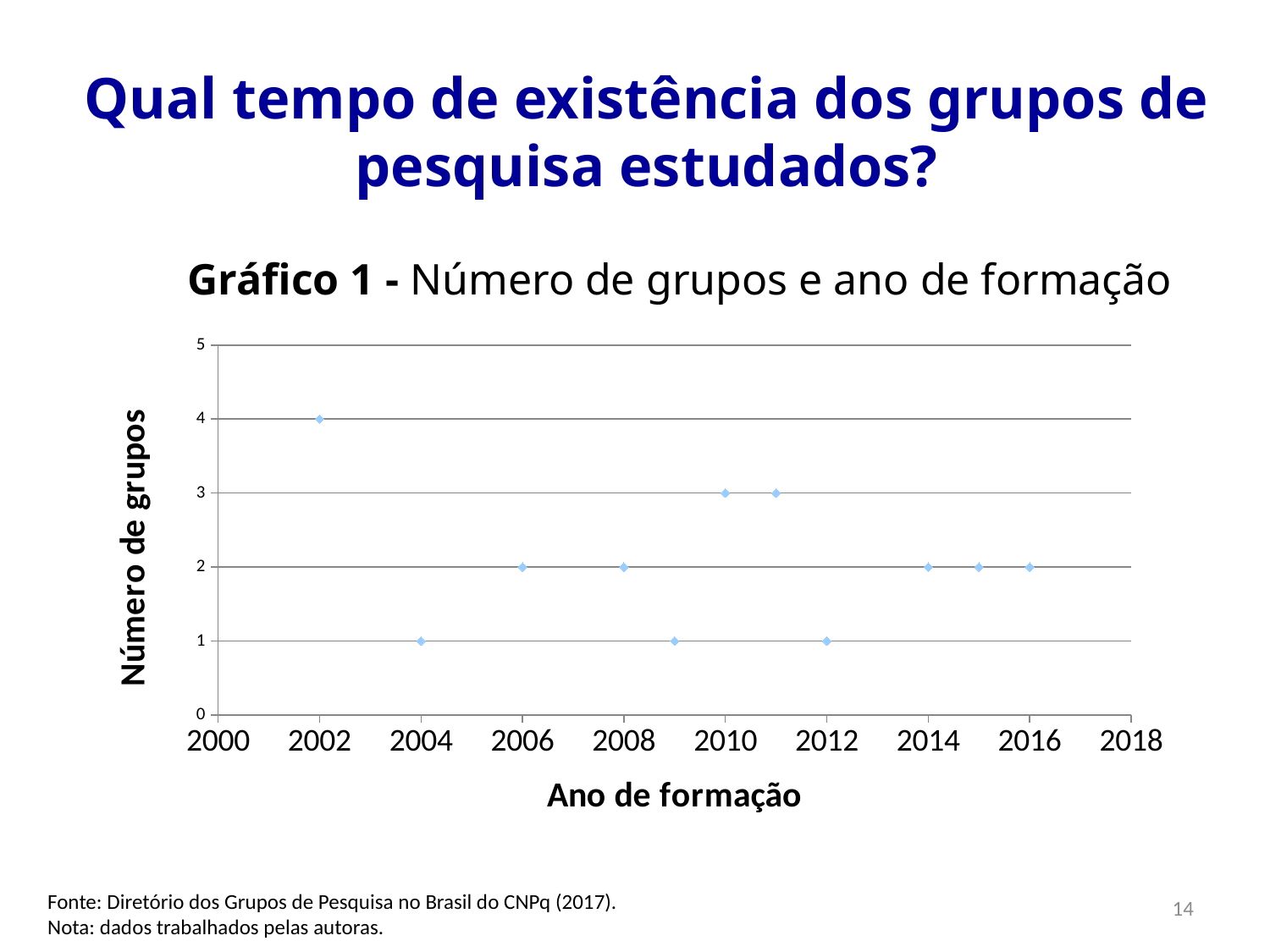
Which year has more groups, 2008 or 2010? 2010 How many groups were formed in 2016? 2 How many data points are plotted on the chart? 11 How many groups were formed in 2010? 3 What is the title of the chart? Gráfico 1 - Número de grupos e ano de formação How many groups were formed in 2004? 1 What is the label of the vertical axis? Número de grupos How many groups were formed in 2002? 4 Which year of formation has the highest number of groups? 2002 What is the difference between the number of groups formed in 2002 and in 2004? 3 What type of chart is shown on the slide? Scatter chart What is the lowest number of groups shown for any year? 1